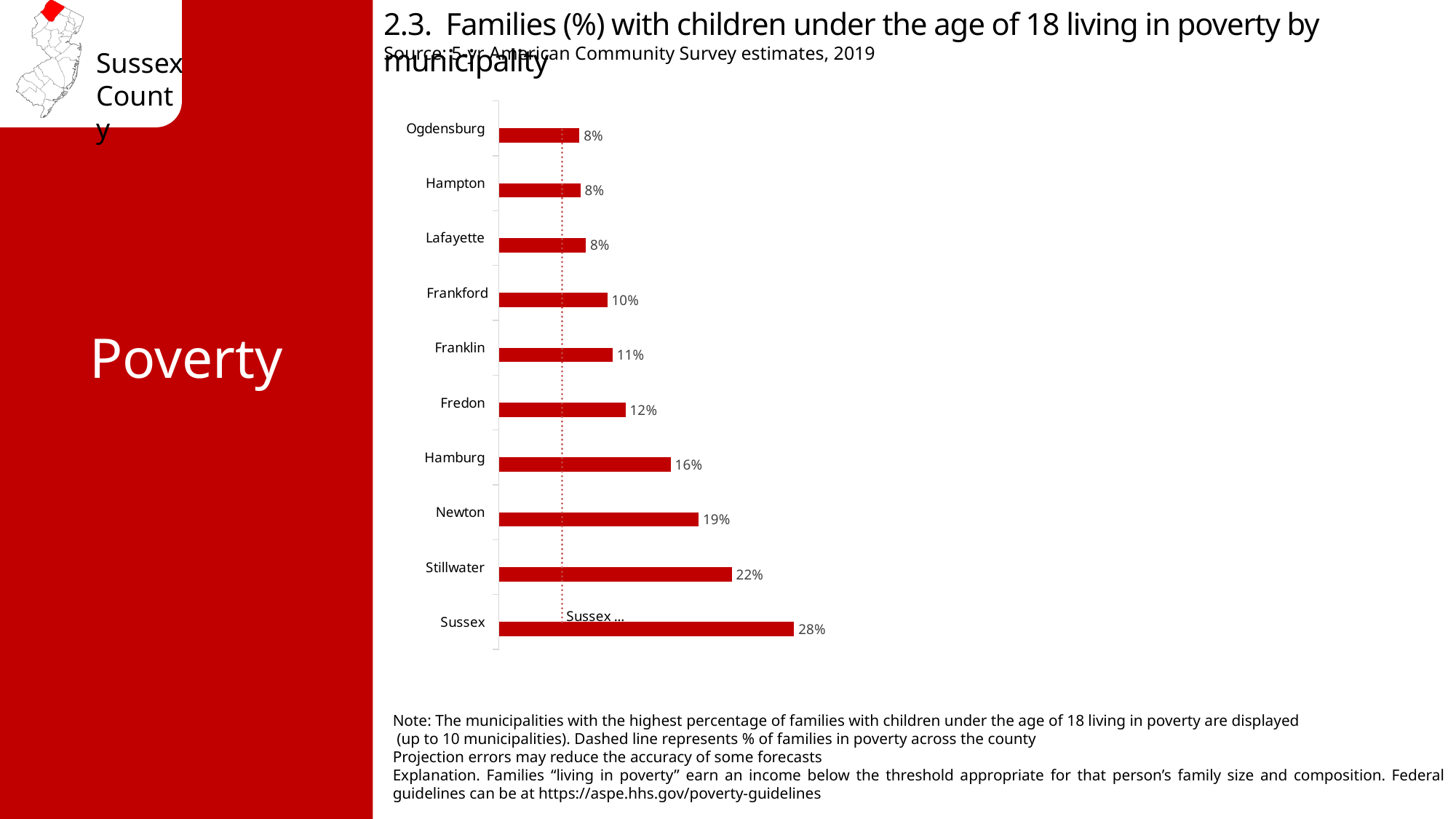
According to the note, what does the dashed line on the chart represent? % of families in poverty across the county What is the difference between the values for Hamburg and Fredon? 4% What kind of chart is used on this slide? Bar chart Which has a higher value, Franklin or Fredon? Fredon What is the value shown for Newton? 19% Which municipality has the highest percentage of families with children under 18 living in poverty? Sussex What is the difference between the values for Sussex and Stillwater? 6% How many municipalities are shown in the chart? 10 What is the value shown for Frankford? 10% Which has a higher value, Newton or Hamburg? Newton What percentage of families with children under 18 are living in poverty in Sussex? 28% Do the values increase or decrease going from the top bar (Ogdensburg) to the bottom bar (Sussex)? Increase